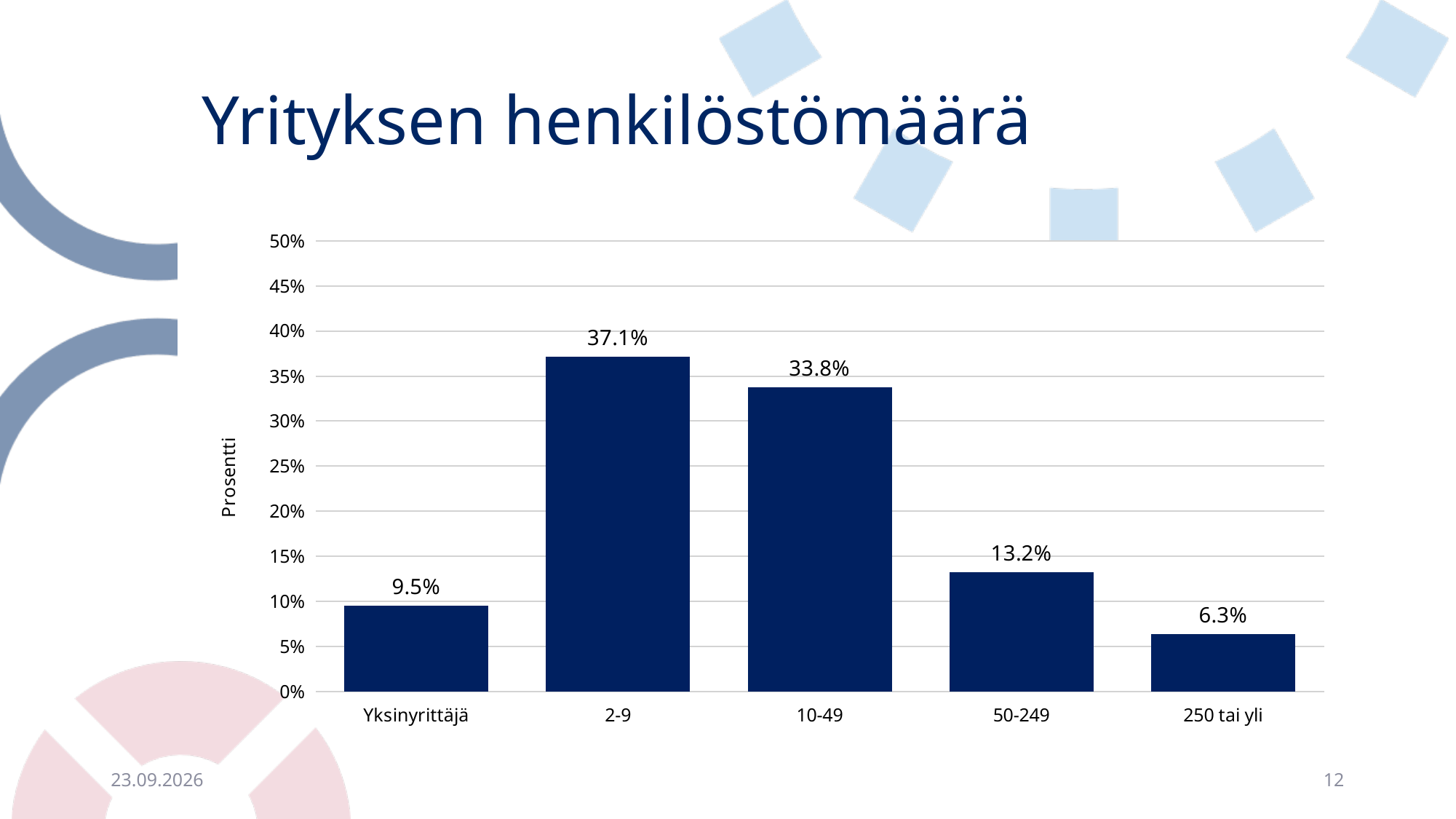
Which category has the lowest value? 250 tai yli What is the value for Yksinyrittäjä? 9.5% What is the value for the 250 tai yli category? 6.3% What kind of chart is shown on the slide? bar chart How many categories are shown on the x axis? 5 What is the label of the vertical axis? Prosentti Is the value for 10-49 greater or less than 30%? greater What is the difference between the values for 2-9 and 10-49? 3.3% What is the value for the 2-9 category? 37.1% Which is larger, the value for Yksinyrittäjä or the value for 50-249? 50-249 Which category has the highest value? 2-9 What is the difference between the values for 50-249 and 250 tai yli? 6.9%